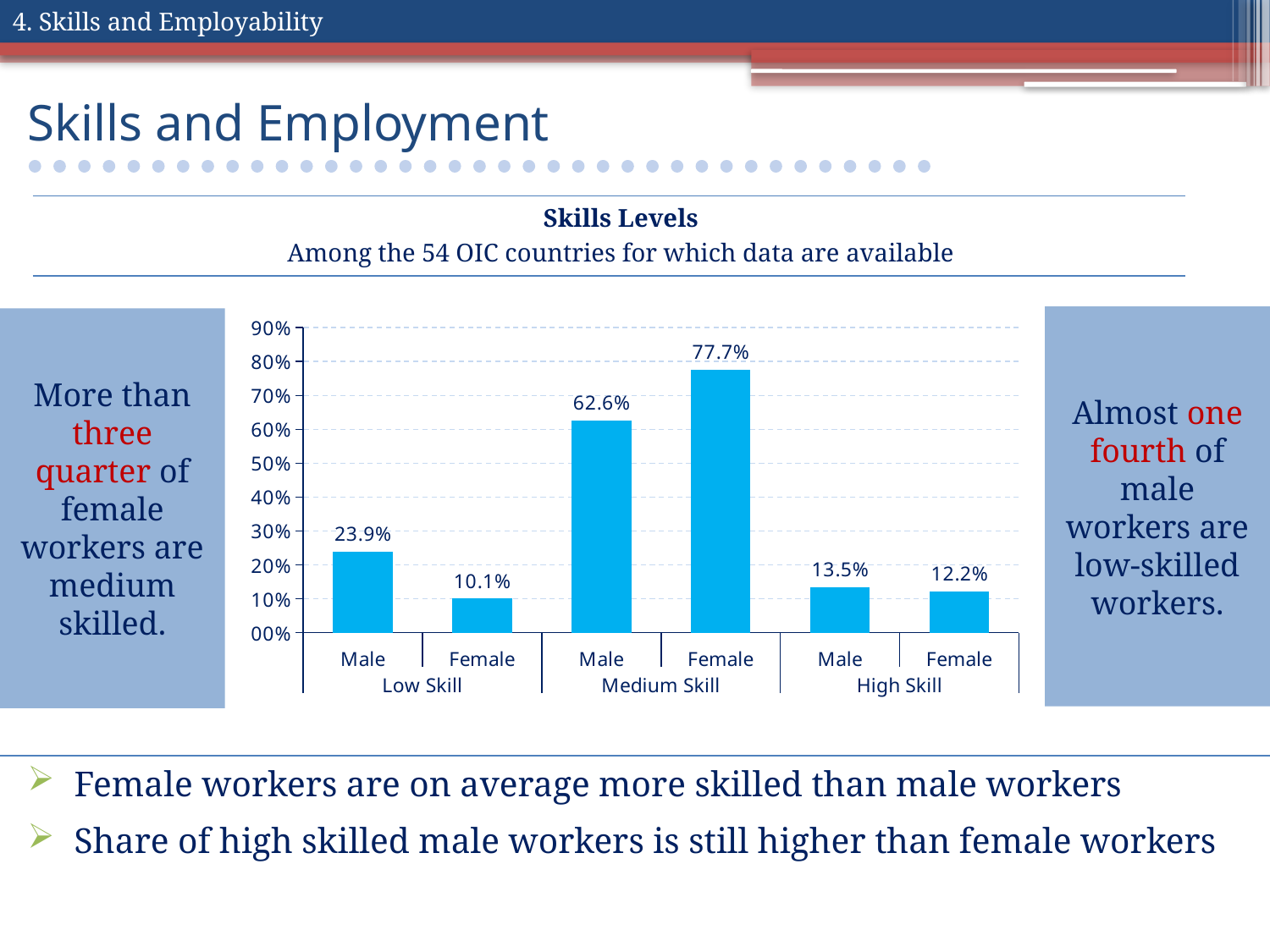
How many bars are plotted on the chart? 6 What is the value for Male workers in the Low Skill group? 23.9% What is the difference between the Female and Male values in the Medium Skill group? 15.1% What is the value for Female workers in the High Skill group? 12.2% Which is larger in the High Skill group, the Male value or the Female value? Male Is the value for Male workers in the Medium Skill group greater or less than 60%? greater What is the difference between the Male and Female values in the Low Skill group? 13.8% What is the value for Female workers in the Medium Skill group? 77.7% Which bar has the lowest value on the chart? Female, Low Skill What is the title of the chart? Skills Levels What kind of chart is shown on the slide? Bar chart Which bar has the highest value on the chart? Female, Medium Skill